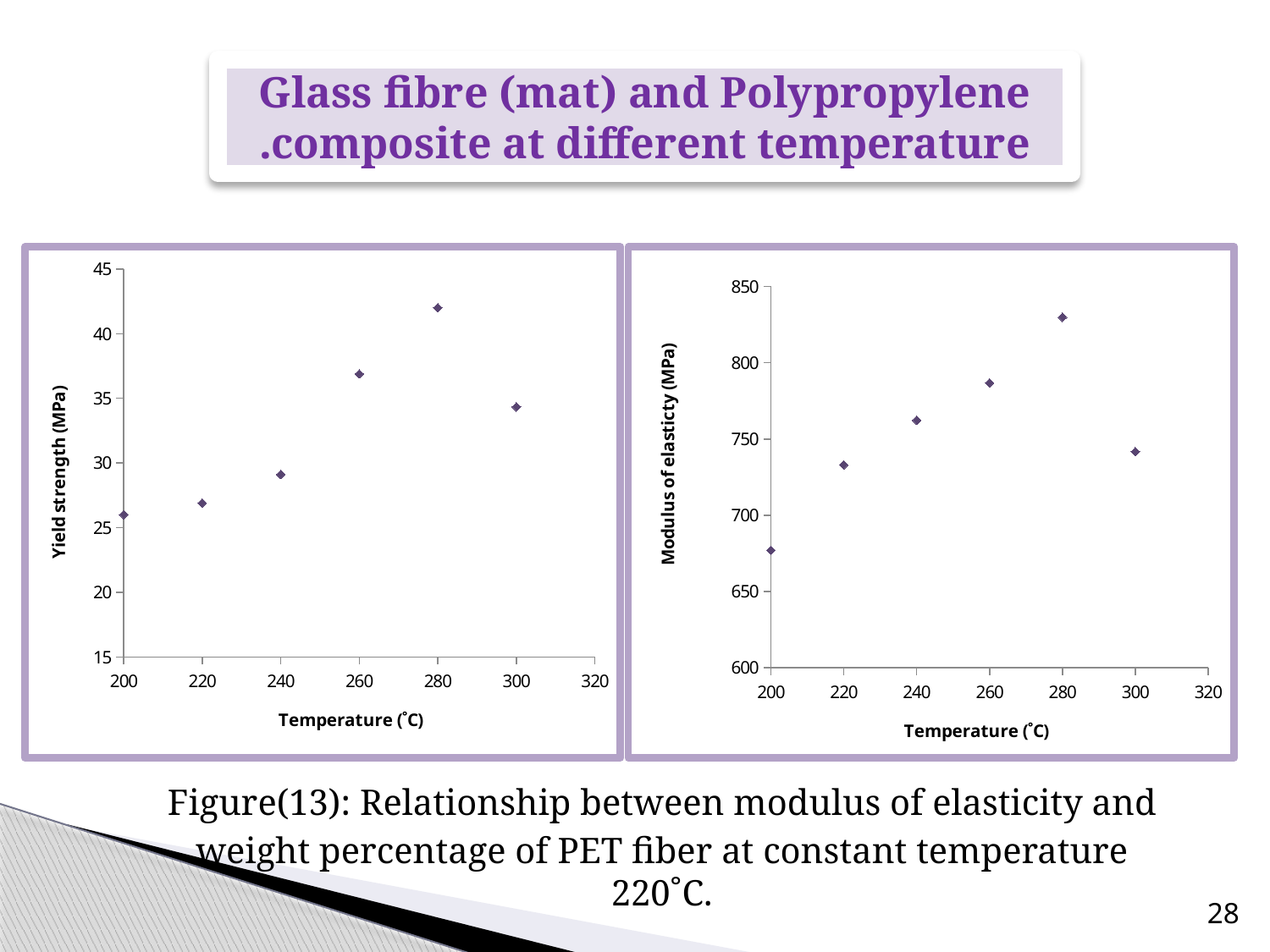
On the left chart (Yield strength vs Temperature), at which temperature is the yield strength highest? 280 On the right chart (Modulus of elasticity vs Temperature), is the modulus of elasticity at 200 greater or less than 700? less On the right chart (Modulus of elasticity vs Temperature), at which temperature is the modulus of elasticity highest? 280 On the right chart (Modulus of elasticity vs Temperature), which is larger: the modulus at 260 or at 300? 260 What is the y-axis title of the right chart? Modulus of elasticty (MPa) How many data points are plotted on the left chart (Yield strength vs Temperature)? 6 How many data points are plotted on the right chart (Modulus of elasticity vs Temperature)? 6 What kind of chart is the left chart (Yield strength vs Temperature)? scatter chart On the left chart (Yield strength vs Temperature), at which temperature is the yield strength lowest? 200 On the left chart (Yield strength vs Temperature), does the yield strength rise or fall from 200 to 280? rise On the left chart (Yield strength vs Temperature), is the yield strength at 280 greater or less than 40? greater On the right chart (Modulus of elasticity vs Temperature), at which temperature is the modulus of elasticity lowest? 200